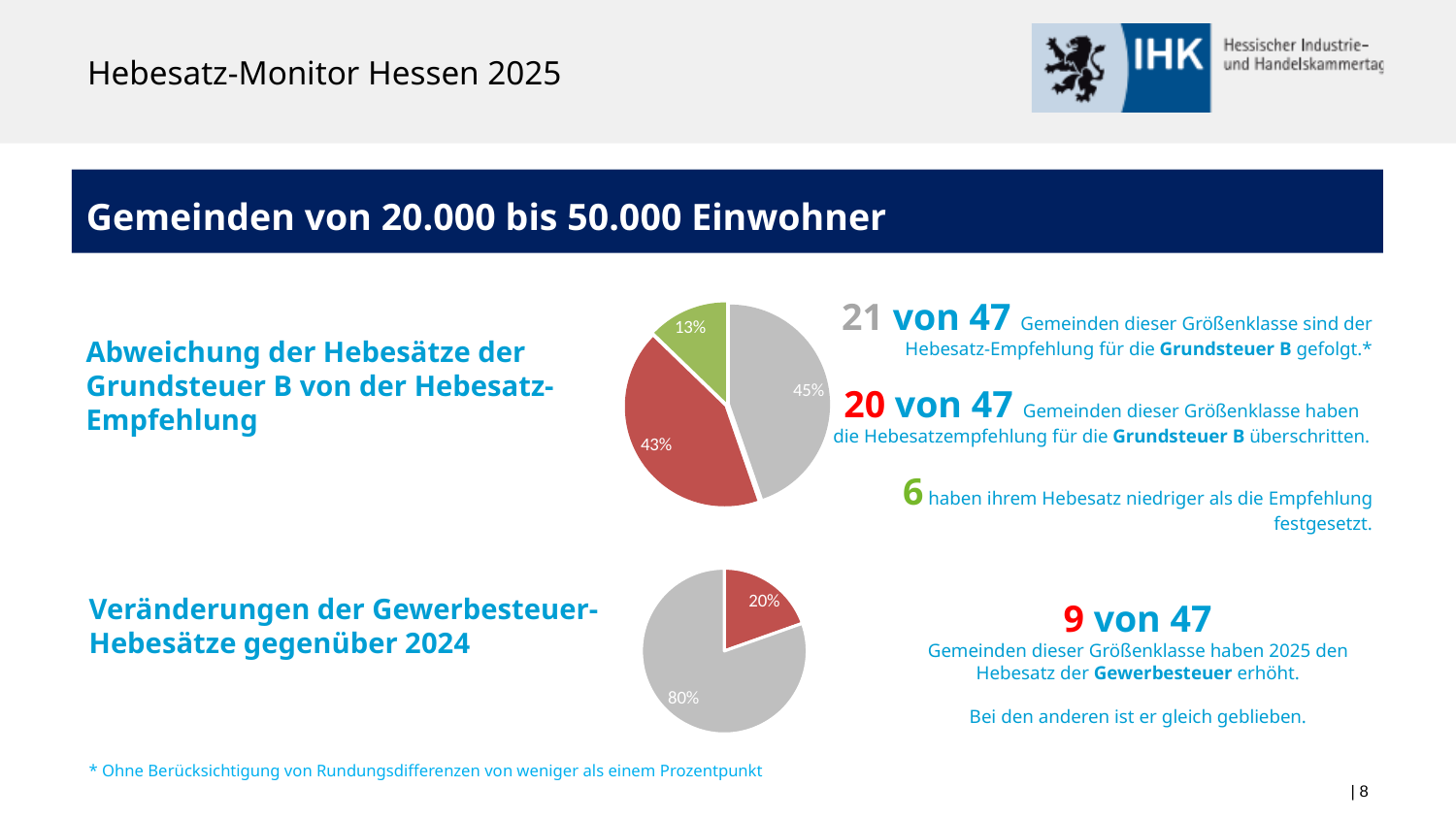
In the top pie chart (Abweichung der Hebesätze der Grundsteuer B), what is the difference in percentage points between the grey slice and the green slice? 32 percentage points In the top pie chart (Abweichung der Hebesätze der Grundsteuer B), what share does the red slice have? 43% In the top pie chart (Abweichung der Hebesätze der Grundsteuer B), how many slices are there? 3 In the bottom pie chart (Veränderungen der Gewerbesteuer-Hebesätze), how many slices are there? 2 In the top pie chart (Abweichung der Hebesätze der Grundsteuer B), what share does the green slice have? 13% In the bottom pie chart (Veränderungen der Gewerbesteuer-Hebesätze), which slice is larger, the grey one or the red one? The grey slice (80%) What kind of chart is shown next to the heading 'Veränderungen der Gewerbesteuer-Hebesätze gegenüber 2024'? Pie chart In the bottom pie chart (Veränderungen der Gewerbesteuer-Hebesätze), what is the difference in percentage points between the grey slice and the red slice? 60 percentage points In the bottom pie chart (Veränderungen der Gewerbesteuer-Hebesätze), what share does the red slice have? 20% What kind of chart is shown next to the heading 'Abweichung der Hebesätze der Grundsteuer B von der Hebesatz-Empfehlung'? Pie chart In the top pie chart (Abweichung der Hebesätze der Grundsteuer B), which slice is the smallest? The green slice (13%)